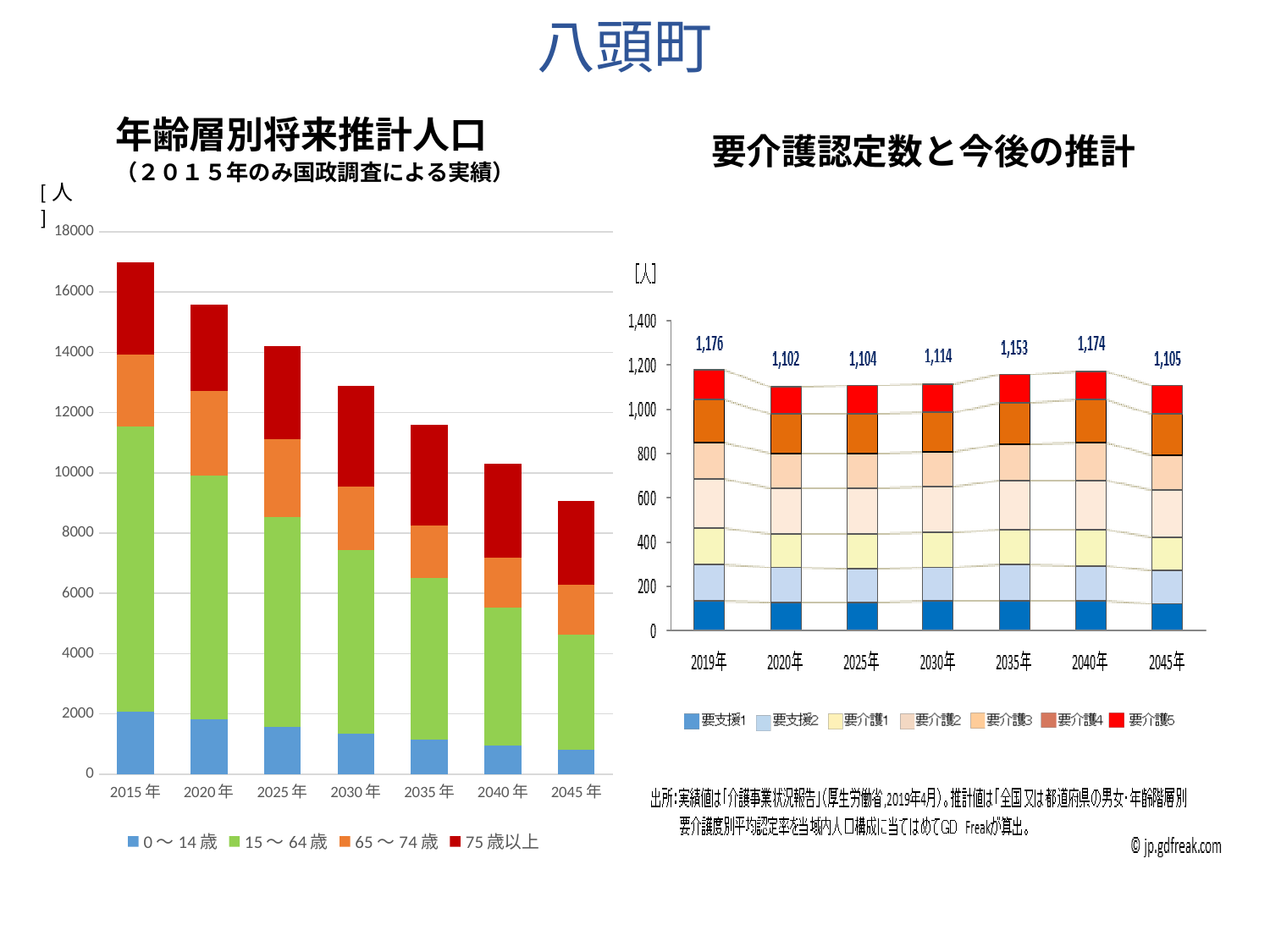
What kind of chart is the 年齢層別将来推計人口 chart on the left? stacked bar chart In the 年齢層別将来推計人口 chart, which year has the tallest total bar? 2015年 In the 年齢層別将来推計人口 chart, do the total bar heights rise or fall from 2015年 to 2045年? fall In the 要介護認定数と今後の推計 chart, what is the difference between the totals for 2019年 and 2020年? 74 How many series does the legend of the 要介護認定数と今後の推計 chart list? 7 In the 要介護認定数と今後の推計 chart, which year has the lowest total? 2020年 How many series does the legend of the 年齢層別将来推計人口 chart list? 4 How many years are shown on the x axis of the 年齢層別将来推計人口 chart? 7 In the 年齢層別将来推計人口 chart, is the total population for 2045年 greater or less than 10000? less In the 要介護認定数と今後の推計 chart, which total is larger, 2040年 or 2045年? 2040年 In the 要介護認定数と今後の推計 chart, what is the total for 2019年? 1,176 In the 年齢層別将来推計人口 chart, is the total population for 2015年 greater or less than 16000? greater